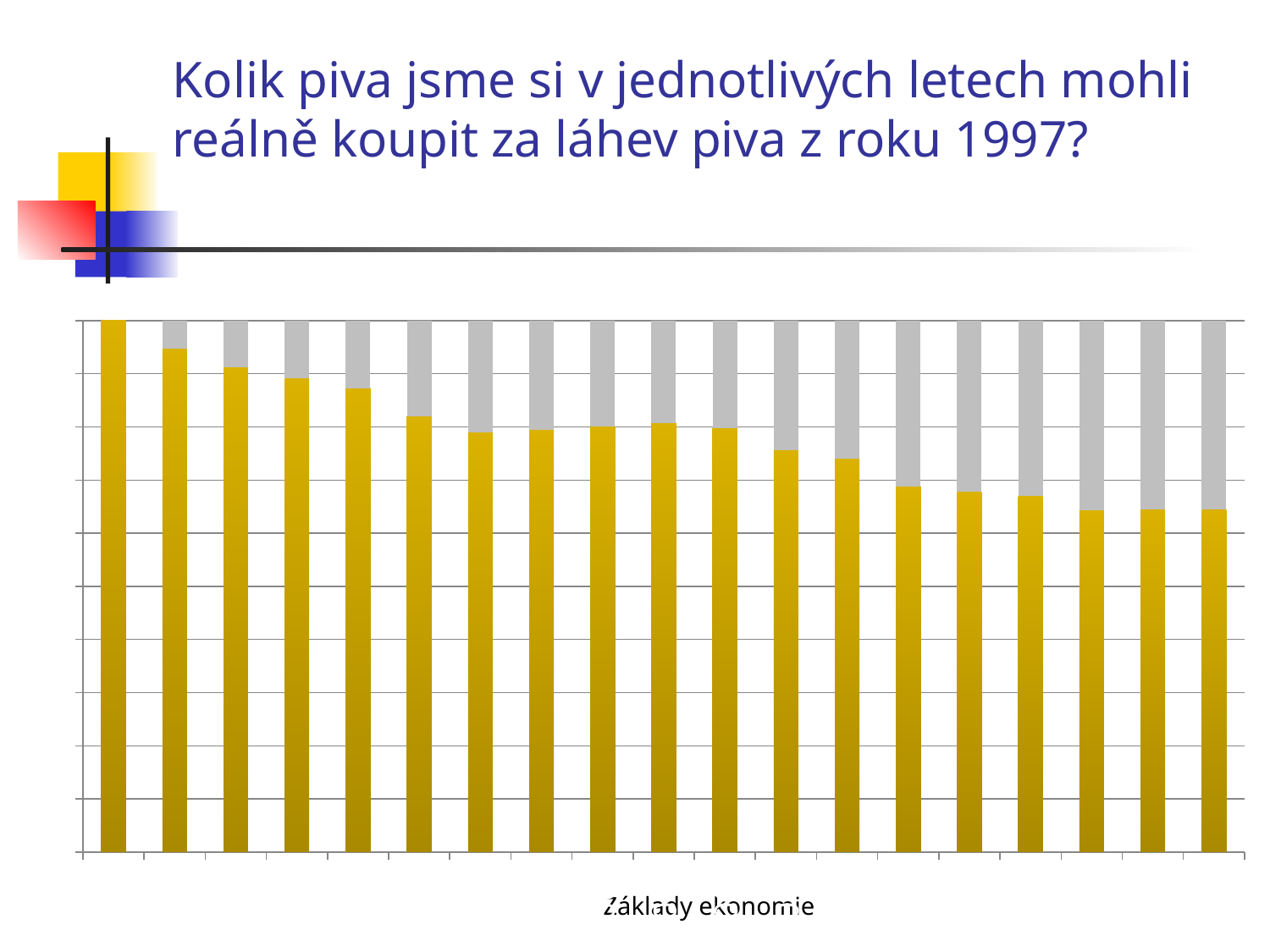
What colour are the bars in the chart? gold/yellow with grey upper segments Is the leftmost bar taller or shorter than the rightmost bar? taller How many bars are plotted in the chart? 19 Do the bar heights generally rise or fall from left to right across the chart? fall Which bar is the tallest in the chart? the leftmost (first) bar Does the chart display a legend? No Is the second bar from the left taller or shorter than the tenth bar from the left? taller What kind of chart is shown on the slide? bar chart Is the fifth bar from the left taller or shorter than the fifteenth bar from the left? taller